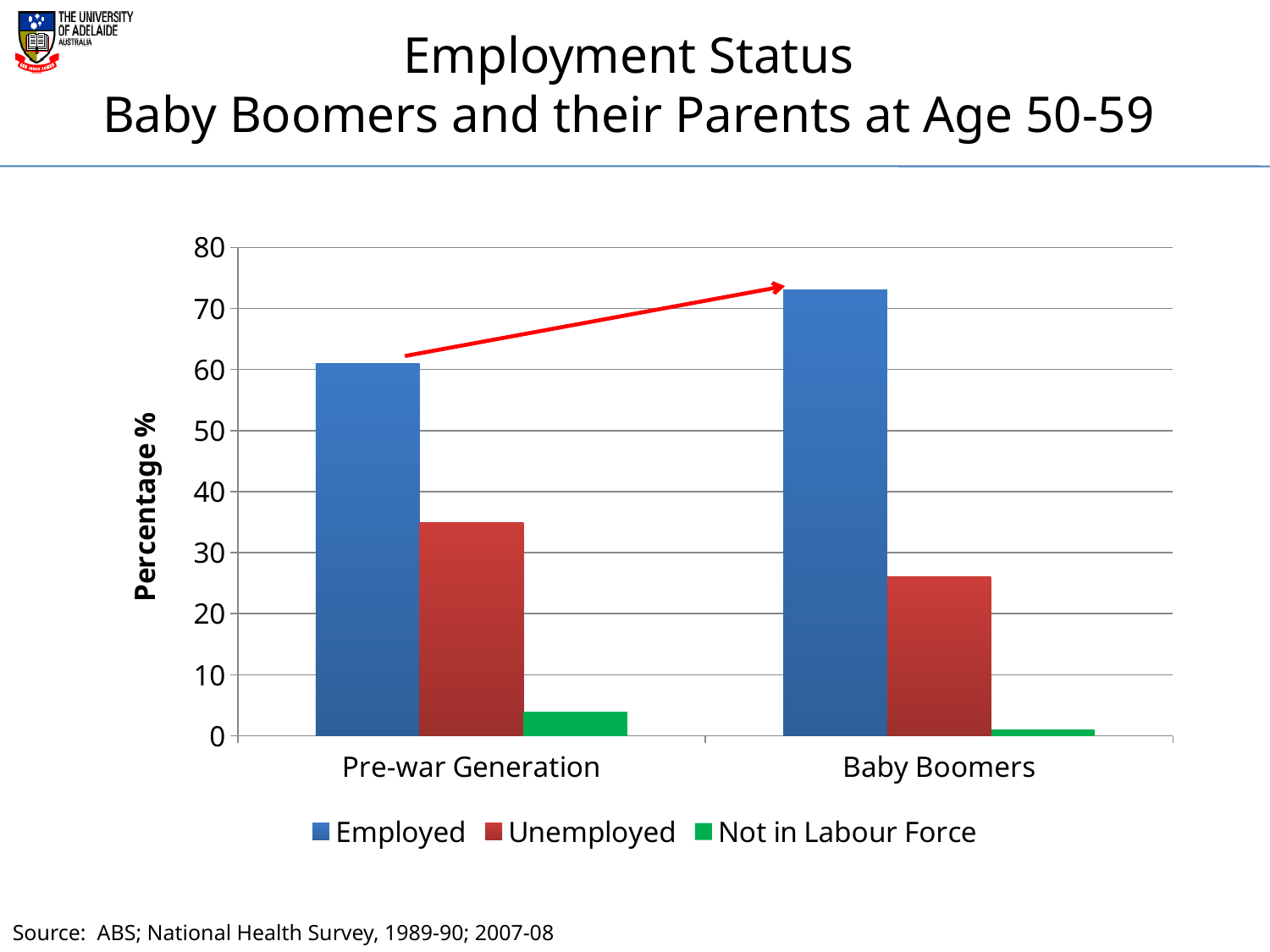
Which generation has the higher Unemployed percentage? Pre-war Generation What is the label on the vertical axis? Percentage % Which generation has the higher Employed percentage? Baby Boomers How many series does the legend list? 3 How many generation categories are shown on the x axis? 2 Which series has the lowest value for Baby Boomers? Not in Labour Force Is the Unemployed value for Baby Boomers greater or less than 30? less Is the Unemployed value for the Pre-war Generation greater or less than 30? greater Is the Employed value for the Pre-war Generation greater or less than 70? less What kind of chart is shown on the slide? bar chart